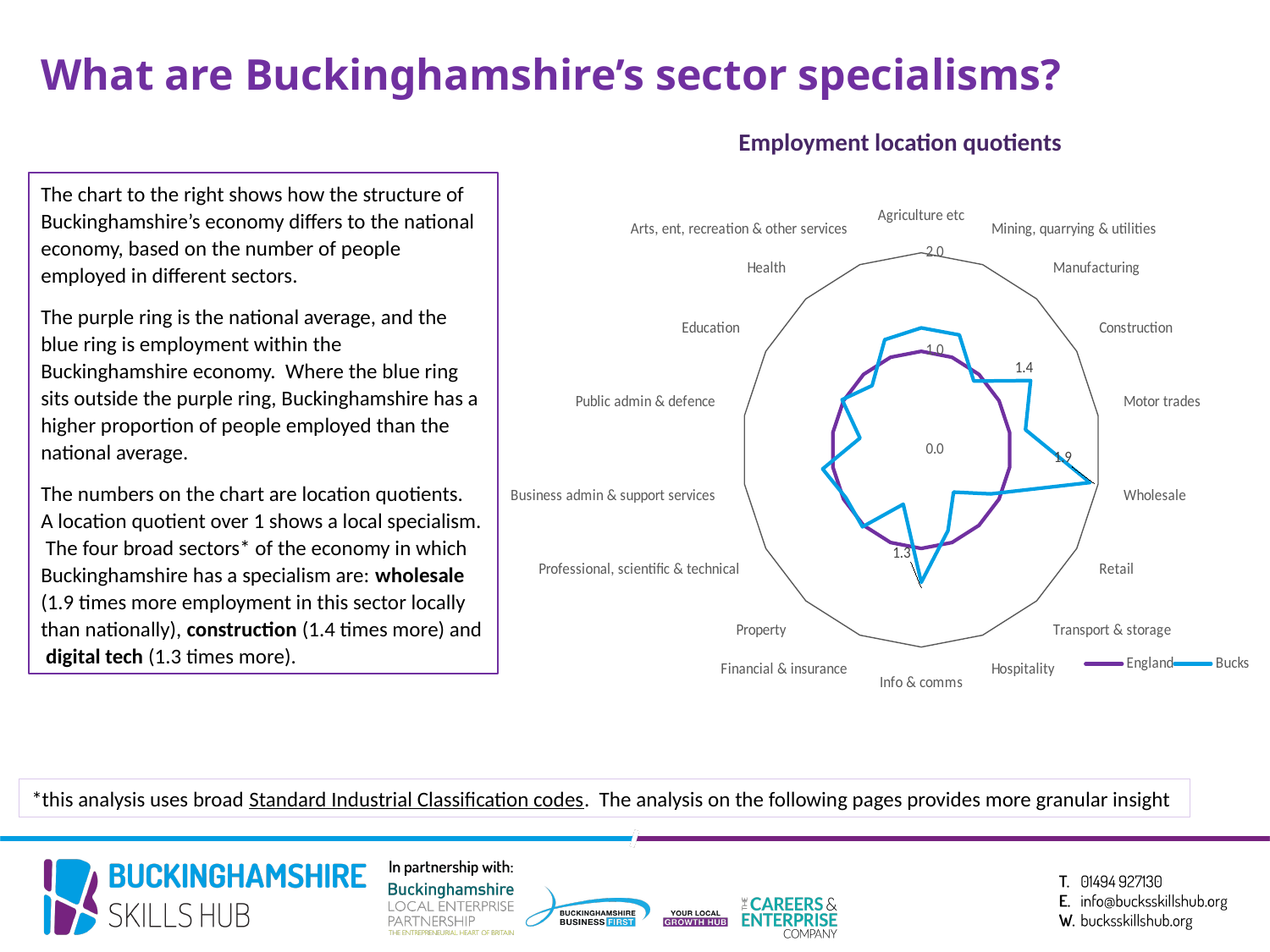
What are the two series named in the chart's legend? England and Bucks What is the Bucks location quotient for Wholesale? 1.9 How many sectors are plotted around the chart? 18 Which is larger for Bucks: the location quotient for Construction or for Info & comms? Construction What is the difference between the Bucks location quotients for Wholesale and Construction? 0.5 What kind of chart is shown on the slide? radar chart What is the Bucks location quotient for Info & comms? 1.3 What is the title of the chart? Employment location quotients Which sector has the highest Bucks location quotient? Wholesale How many series does the chart's legend list? 2 What is the Bucks location quotient for Construction? 1.4 Is the Bucks value for Public admin & defence greater or less than 1.0? less